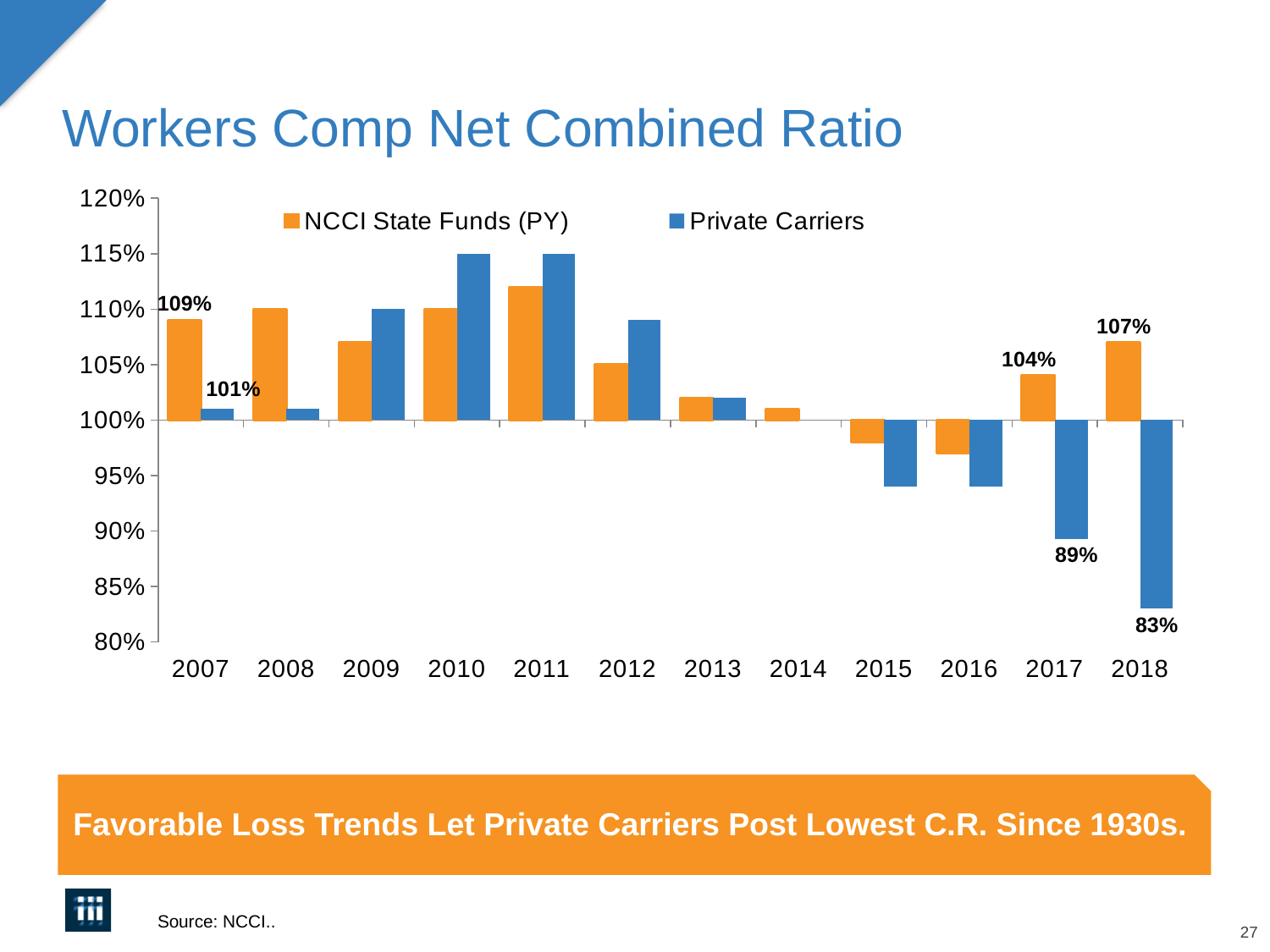
What kind of chart is shown on the slide? Bar chart What is the Private Carriers combined ratio for 2007? 101% What is the difference between the NCCI State Funds (PY) and Private Carriers combined ratios in 2018? 24 percentage points In which year is the Private Carriers combined ratio lowest? 2018 What is the NCCI State Funds (PY) combined ratio for 2018? 107% What is the Private Carriers combined ratio for 2017? 89% How many series does the legend list? 2 What is the NCCI State Funds (PY) combined ratio for 2007? 109% How many years are shown on the x axis? 12 In 2017, which series has the higher combined ratio, NCCI State Funds (PY) or Private Carriers? NCCI State Funds (PY) What is the Private Carriers combined ratio for 2018? 83% Is the Private Carriers value for 2010 greater or less than 110%? greater